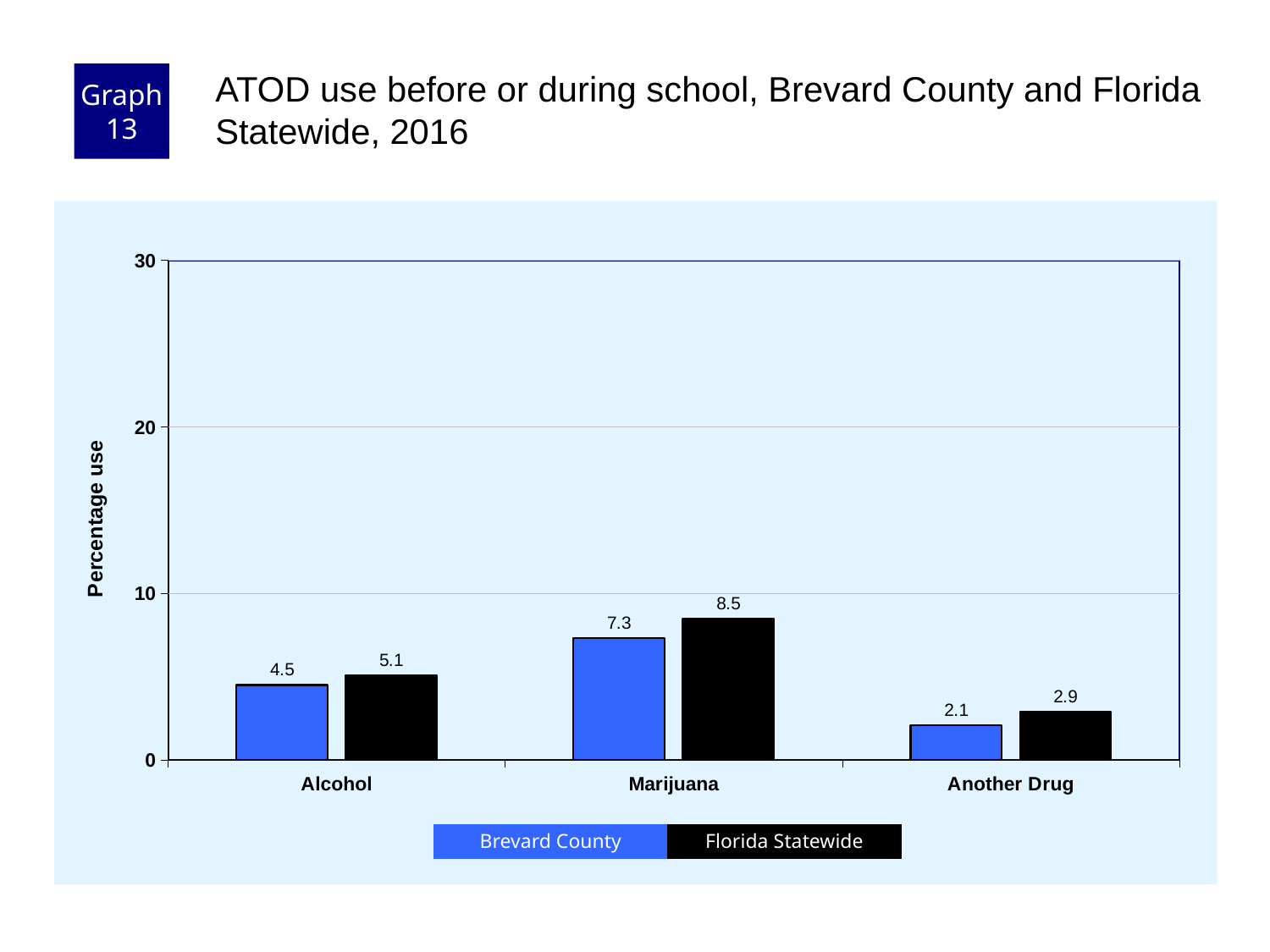
Is the Florida Statewide value for Marijuana greater or less than 10? less How many categories are shown on the x axis? 3 What is the difference between the Florida Statewide and Brevard County values for Another Drug? 0.8 What is the difference between the Florida Statewide and Brevard County values for Marijuana? 1.2 Which category has the lowest Brevard County value? Another Drug Which is larger for Alcohol: the Brevard County value or the Florida Statewide value? Florida Statewide Which category has the highest Florida Statewide value? Marijuana What is the Brevard County value for Another Drug? 2.1 How many series does the legend list? 2 What kind of chart is shown on the slide? bar chart What is the Florida Statewide value for Marijuana? 8.5 What is the Brevard County value for Alcohol? 4.5